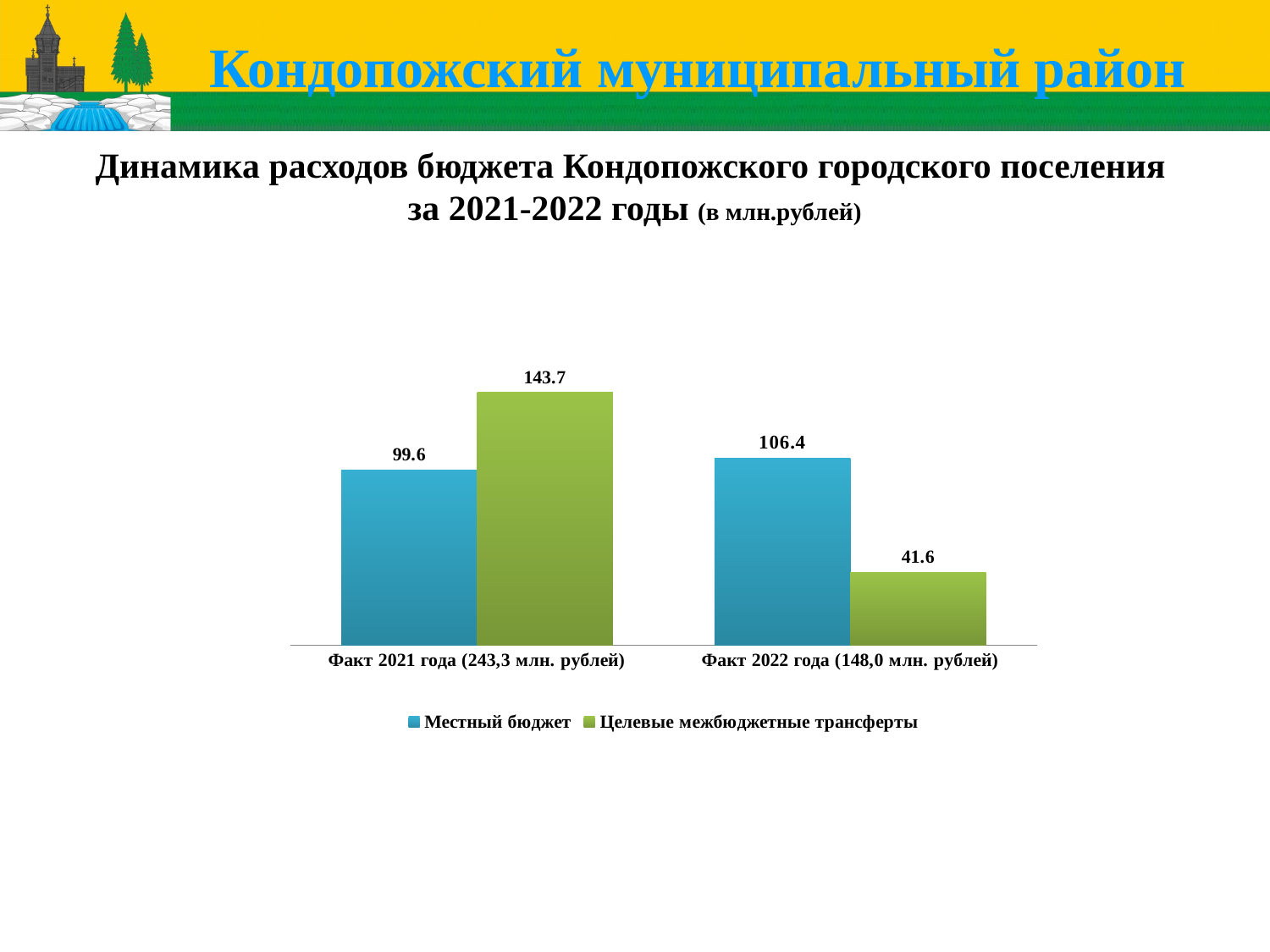
Does the value of Целевые межбюджетные трансферты rise or fall from 2021 to 2022? Fall What is the value of Целевые межбюджетные трансферты for Факт 2021 года? 143.7 What is the difference between Местный бюджет in 2022 and in 2021? 6.8 How many series does the legend list? 2 What is the value of Местный бюджет for Факт 2021 года? 99.6 What is the difference between Целевые межбюджетные трансферты in 2021 and in 2022? 102.1 What is the value of Целевые межбюджетные трансферты for Факт 2022 года? 41.6 Which bar has the highest value on the chart? Целевые межбюджетные трансферты, Факт 2021 года (143.7) What is the value of Местный бюджет for Факт 2022 года? 106.4 Which bar has the lowest value on the chart? Целевые межбюджетные трансферты, Факт 2022 года (41.6) What kind of chart is shown on the slide? Bar chart Which is larger for Факт 2022 года: Местный бюджет or Целевые межбюджетные трансферты? Местный бюджет